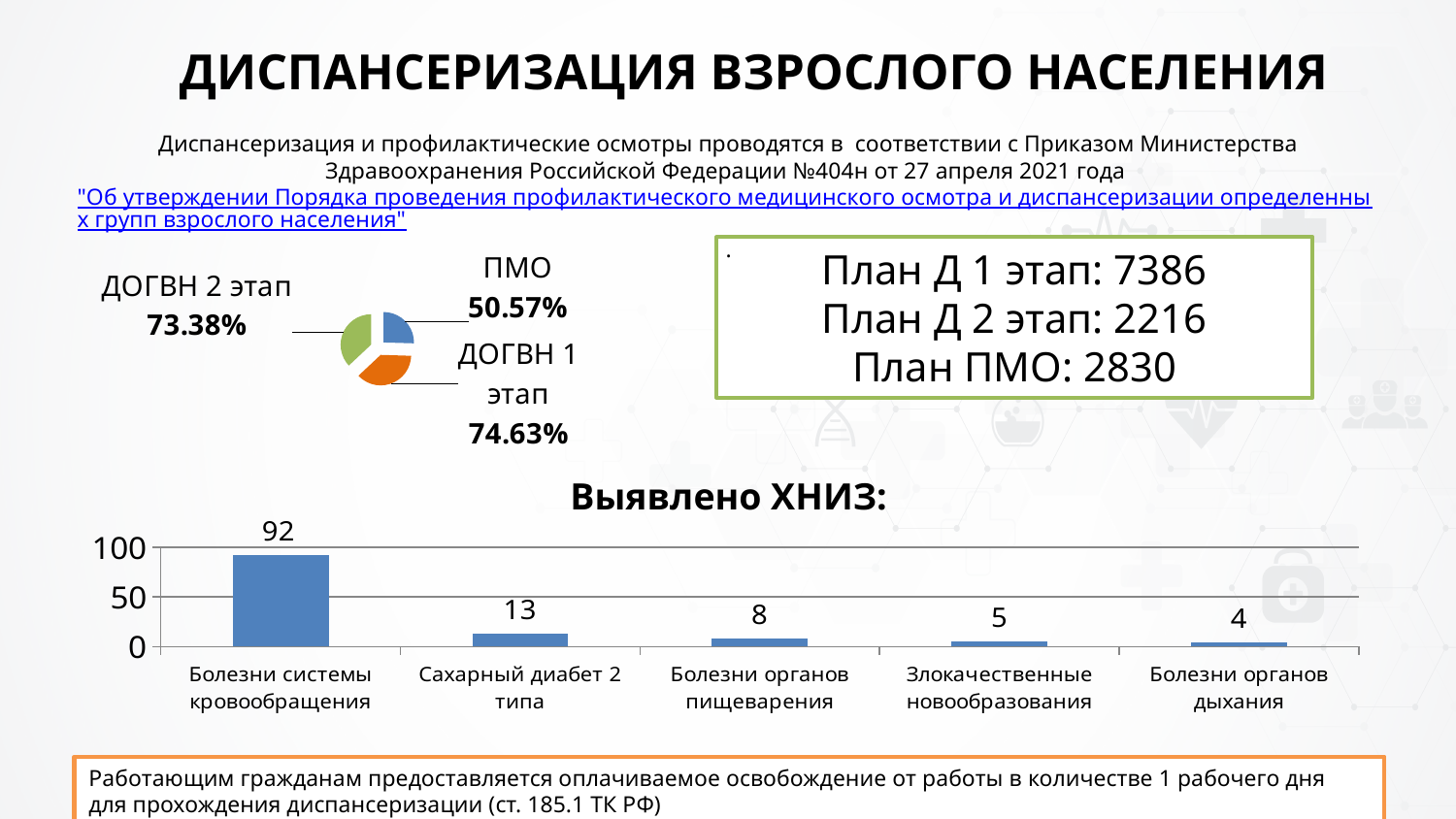
In the bar chart 'Выявлено ХНИЗ', which category has the lowest value? Болезни органов дыхания What kind of chart is the chart titled 'Выявлено ХНИЗ'? bar chart In the bar chart 'Выявлено ХНИЗ', what is the value for 'Болезни системы кровообращения'? 92 In the bar chart 'Выявлено ХНИЗ', which is larger: the value for 'Болезни органов пищеварения' or 'Болезни органов дыхания'? Болезни органов пищеварения In the bar chart 'Выявлено ХНИЗ', what is the difference between the values for 'Болезни системы кровообращения' and 'Сахарный диабет 2 типа'? 79 In the bar chart 'Выявлено ХНИЗ', do the values rise or fall from left to right? fall In the bar chart 'Выявлено ХНИЗ', which category has the highest value? Болезни системы кровообращения In the bar chart 'Выявлено ХНИЗ', how many categories are shown? 5 In the bar chart 'Выявлено ХНИЗ', what is the value for 'Сахарный диабет 2 типа'? 13 In the pie chart at the top left of the slide, what percentage is shown for 'ДОГВН 1 этап'? 74.63% In the pie chart at the top left of the slide, what percentage is shown for 'ПМО'? 50.57% In the bar chart 'Выявлено ХНИЗ', what is the value for 'Злокачественные новообразования'? 5